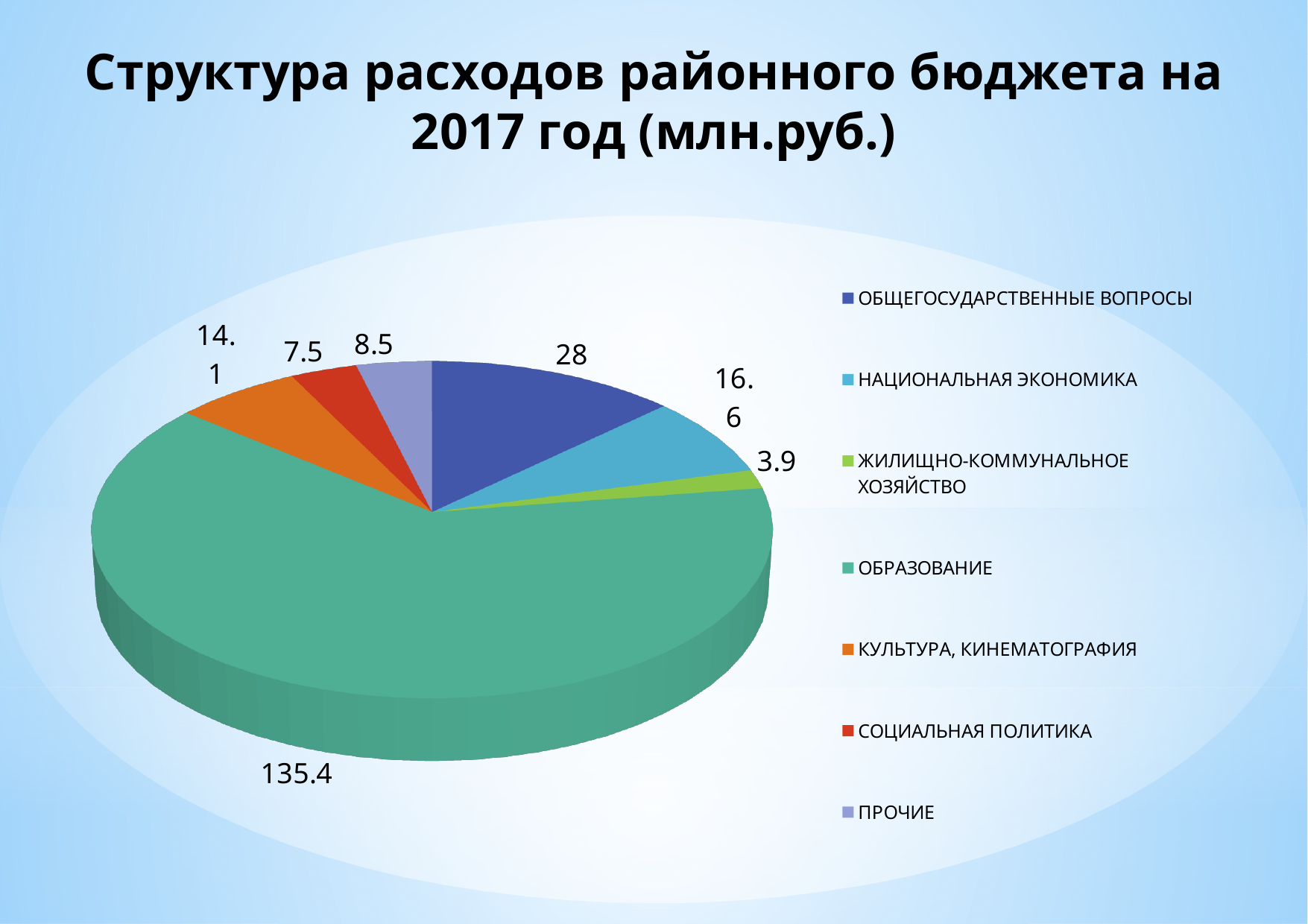
What is the value for ЖИЛИЩНО-КОММУНАЛЬНОЕ ХОЗЯЙСТВО? 3.9 What is the difference between the values for ОБРАЗОВАНИЕ and ОБЩЕГОСУДАРСТВЕННЫЕ ВОПРОСЫ? 107.4 What is the value for ПРОЧИЕ? 8.5 What is the value for СОЦИАЛЬНАЯ ПОЛИТИКА? 7.5 Which category has the largest slice of the pie? ОБРАЗОВАНИЕ Which category has the smallest slice of the pie? ЖИЛИЩНО-КОММУНАЛЬНОЕ ХОЗЯЙСТВО What is the title of the chart on the slide? Структура расходов районного бюджета на 2017 год (млн.руб.) What is the value for ОБРАЗОВАНИЕ? 135.4 Which is larger, the value for ПРОЧИЕ or the value for СОЦИАЛЬНАЯ ПОЛИТИКА? ПРОЧИЕ How many categories does the legend list? 7 What type of chart is shown on the slide? Pie chart What is the value for ОБЩЕГОСУДАРСТВЕННЫЕ ВОПРОСЫ? 28